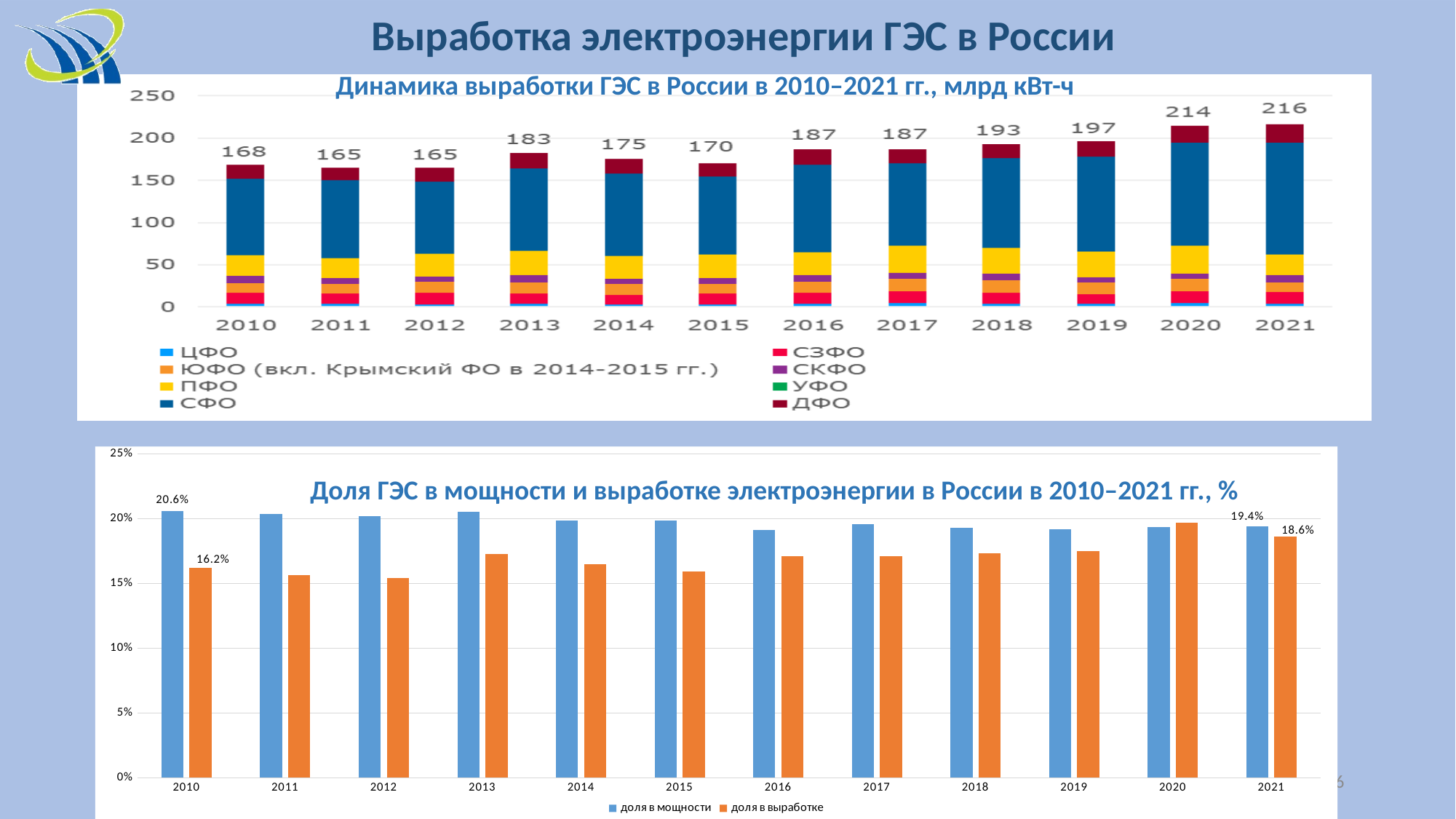
In the bottom chart (Доля ГЭС в мощности и выработке), what is the value of доля в мощности for 2010? 20.6% In the top chart (Динамика выработки ГЭС в России), how many series does the legend list? 8 In the top chart (Динамика выработки ГЭС в России), which year has the highest total? 2021 In the top chart (Динамика выработки ГЭС в России), what is the lowest total value shown? 165 In the bottom chart (Доля ГЭС в мощности и выработке), which is larger for 2010: доля в мощности or доля в выработке? доля в мощности In the top chart (Динамика выработки ГЭС в России), do the totals generally rise or fall from 2015 to 2021? Rise In the top chart (Динамика выработки ГЭС в России), what is the total value for 2021? 216 In the bottom chart (Доля ГЭС в мощности и выработке), is the value of доля в выработке for 2012 greater or less than 20%? less In the top chart (Динамика выработки ГЭС в России), how many years are shown on the x axis? 12 What kind of chart is the top chart (Динамика выработки ГЭС в России)? Stacked bar chart In the top chart (Динамика выработки ГЭС в России), what is the difference between the totals for 2021 and 2010? 48 In the bottom chart (Доля ГЭС в мощности и выработке), what is the value of доля в выработке for 2021? 18.6%